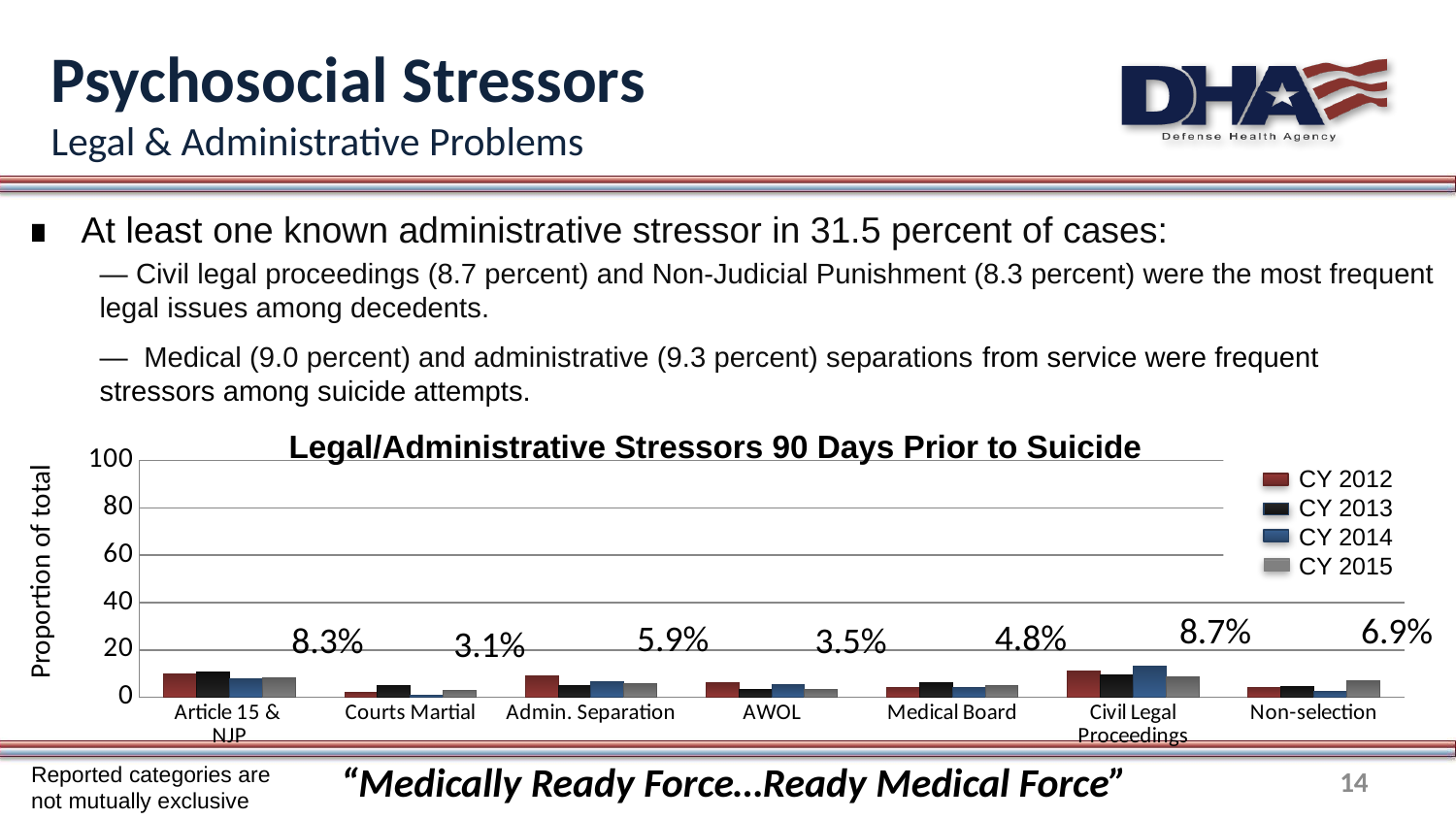
What data label is printed above the Admin. Separation group? 5.9% What is the difference between the printed labels for Civil Legal Proceedings (8.7%) and Courts Martial (3.1%)? 5.6% What data label is printed above the Civil Legal Proceedings group? 8.7% Which category has the lowest printed data label? Courts Martial How many categories are shown along the x axis of the chart? 7 Is the CY 2012 value for Article 15 & NJP greater or less than 20? less Which category has the highest printed data label? Civil Legal Proceedings What kind of chart is shown on the slide? bar chart What data label is printed above the Courts Martial group? 3.1% What is the title of the chart? Legal/Administrative Stressors 90 Days Prior to Suicide Which printed label is larger, Civil Legal Proceedings or Non-selection? Civil Legal Proceedings How many series does the chart legend list? 4